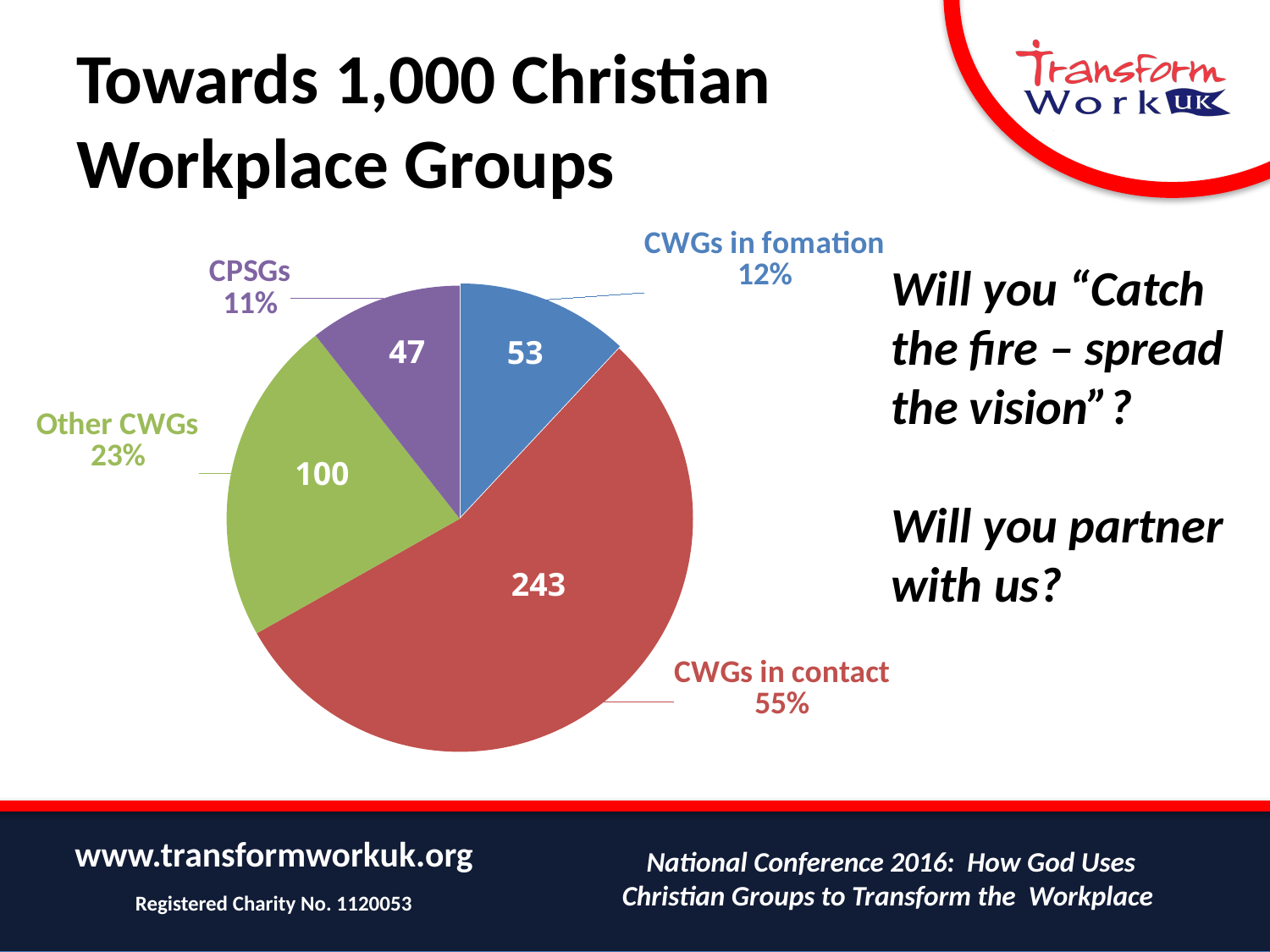
What share of the pie is CWGs in contact? 55% What is the value for CPSGs? 47 How many slices does the pie chart have? 4 Which is larger, the value for CWGs in fomation or the value for CPSGs? CWGs in fomation What is the difference between the values for CWGs in contact and Other CWGs? 143 What kind of chart is shown on the slide? pie chart What share of the pie is Other CWGs? 23% What is the value for CWGs in contact? 243 What is the value for Other CWGs? 100 What is the value for CWGs in fomation? 53 Which category has the smallest slice? CPSGs Which category has the largest slice? CWGs in contact